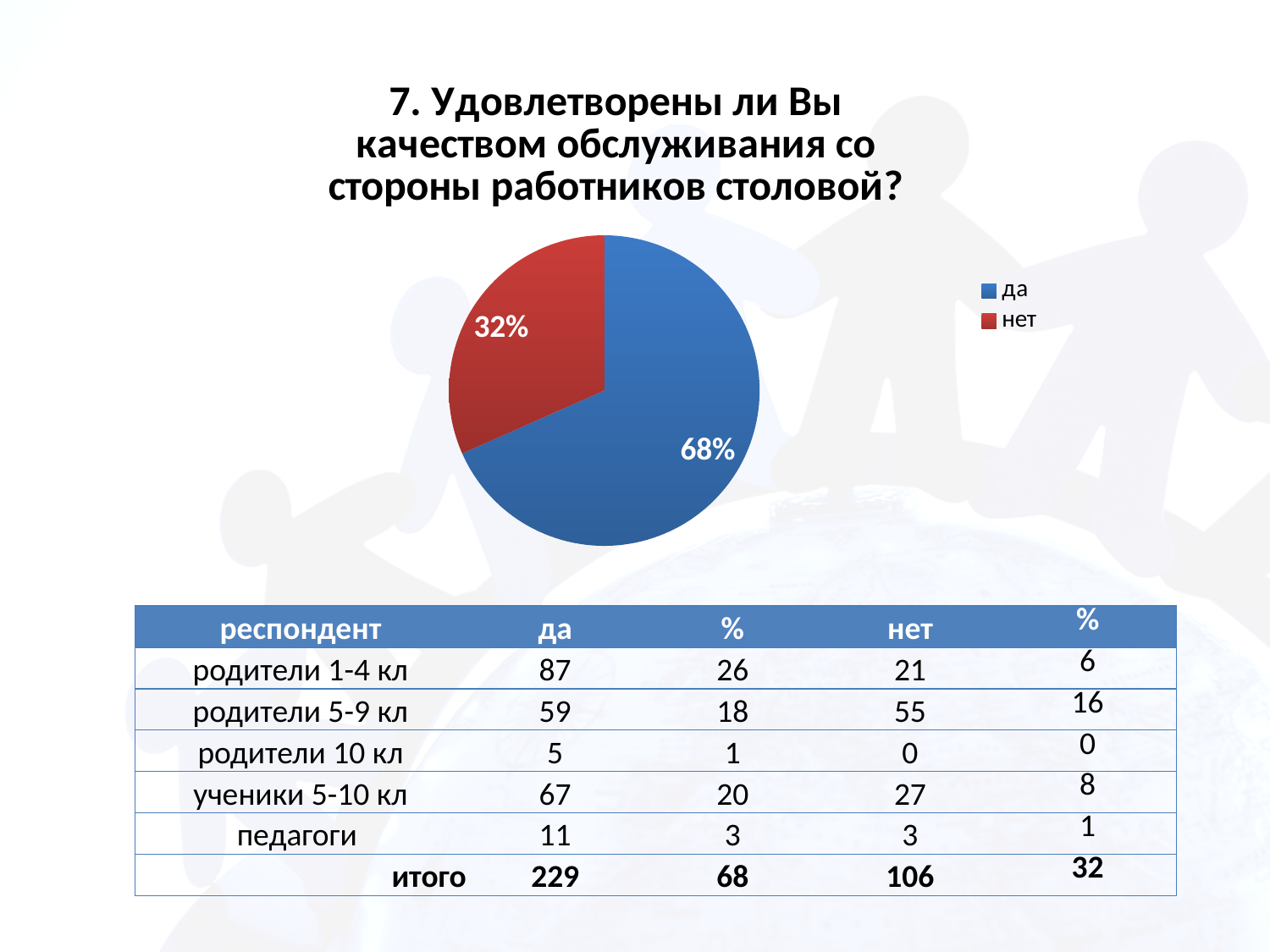
What is the title of the chart? 7. Удовлетворены ли Вы качеством обслуживания со стороны работников столовой? What is the difference in percentage points between the "да" and "нет" slices? 36 How many entries does the legend list? 2 What share of the pie does the "нет" slice represent? 32% What colour is the "нет" slice in the pie chart? red Which is larger, the "да" slice or the "нет" slice? да How many slices does the pie chart have? 2 What kind of chart is shown on the slide? pie chart What share of the pie does the "да" slice represent? 68% Which slice of the pie is the largest? да Which slice of the pie is the smallest? нет